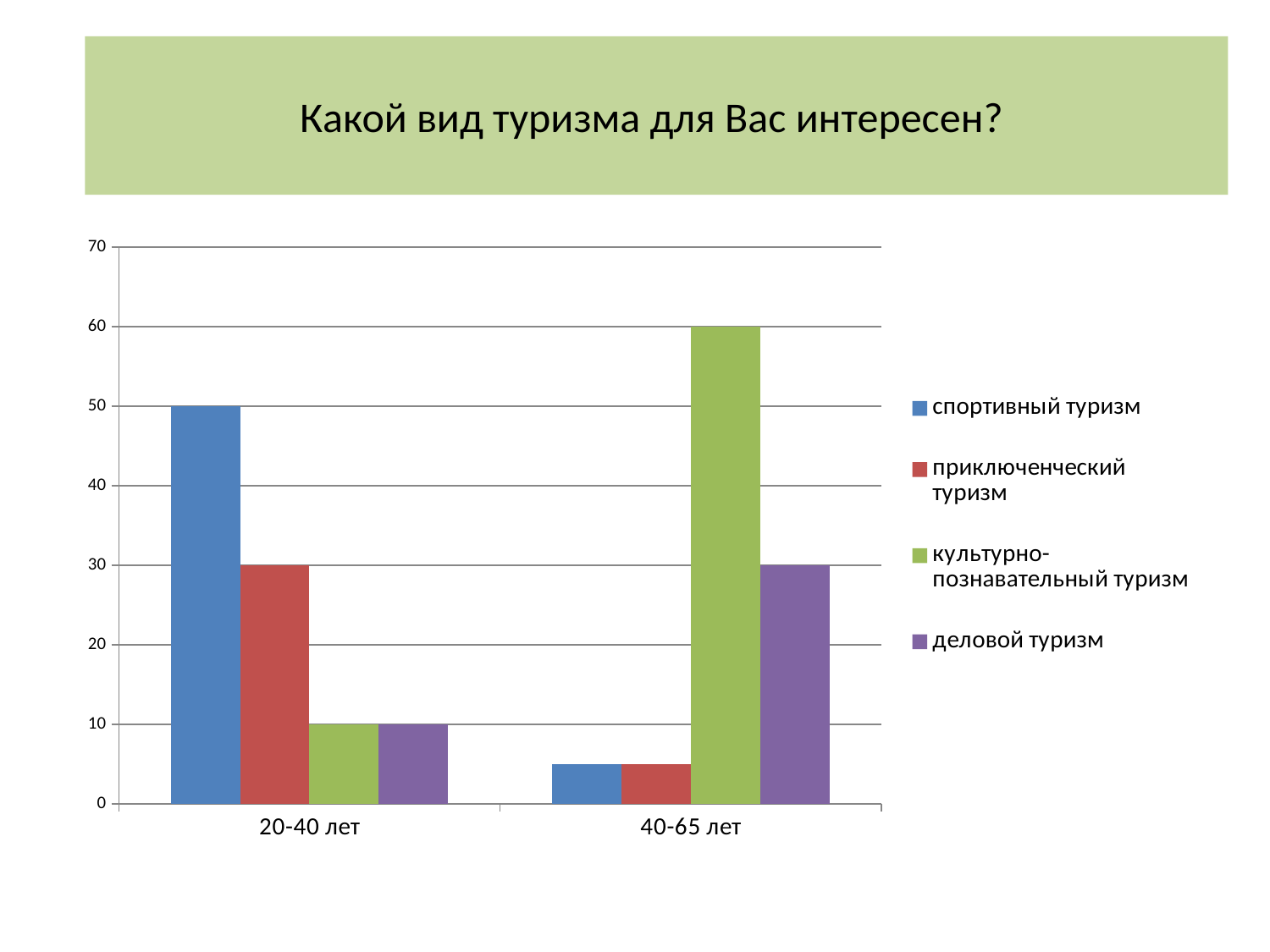
Which type of tourism has the highest value in the 20-40 лет group? спортивный туризм Is the value for спортивный туризм in the 40-65 лет group greater or less than 10? less Which type of tourism has the highest value in the 40-65 лет group? культурно-познавательный туризм What is the value for спортивный туризм in the 20-40 лет group? 50 How many series does the legend list? 4 What is the value for деловой туризм in the 40-65 лет group? 30 How many age-group categories are shown on the x axis? 2 What is the difference between спортивный туризм in the 20-40 лет group and приключенческий туризм in the same group? 20 Which is larger: культурно-познавательный туризм for 40-65 лет or спортивный туризм for 20-40 лет? культурно-познавательный туризм for 40-65 лет What is the value for культурно-познавательный туризм in the 40-65 лет group? 60 What kind of chart is shown on the slide? bar chart What is the value for приключенческий туризм in the 20-40 лет group? 30